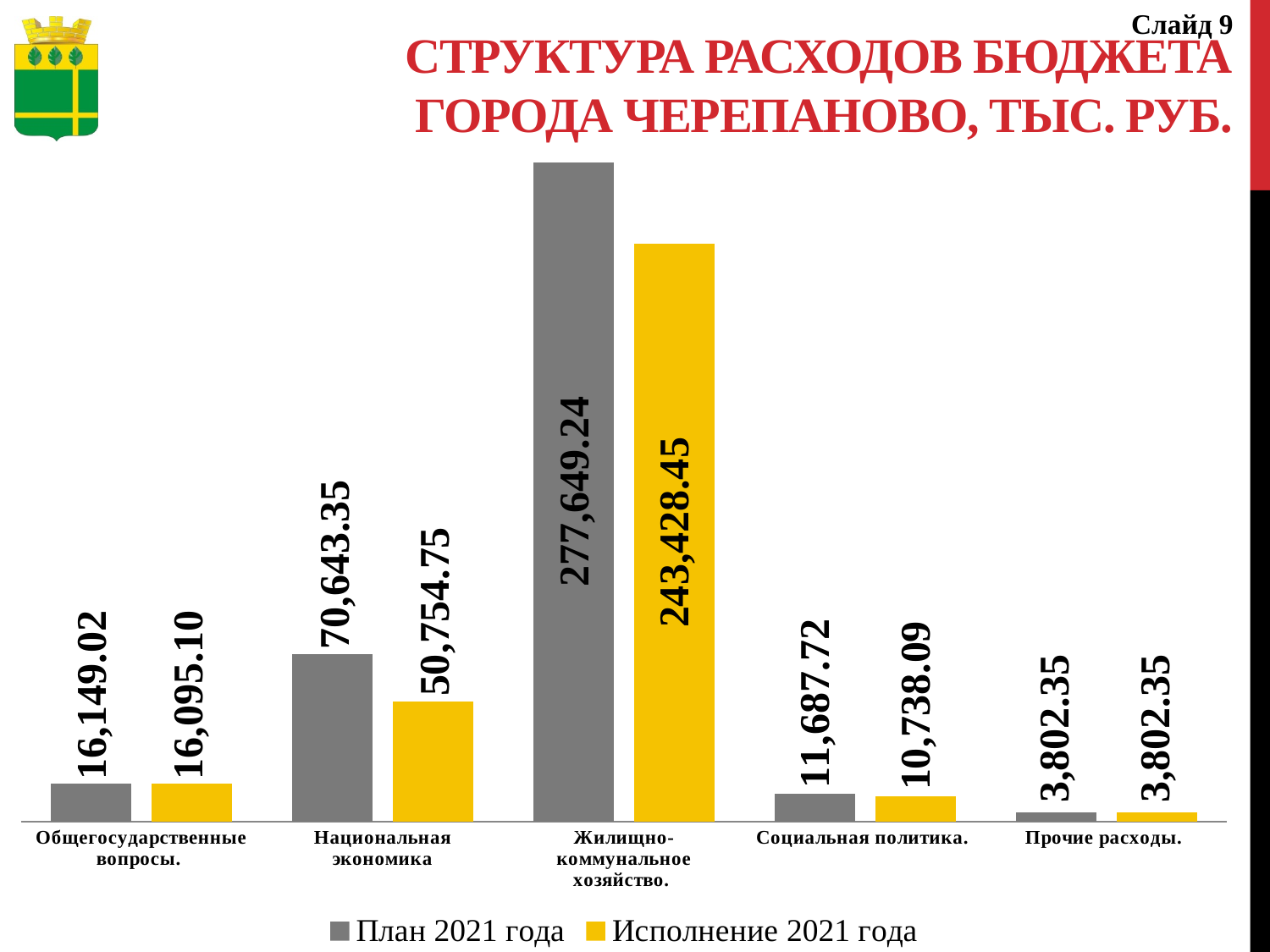
What is the value of Исполнение 2021 года for Социальная политика? 10,738.09 Which category has the highest value for План 2021 года? Жилищно-коммунальное хозяйство Which category has the lowest value for Исполнение 2021 года? Прочие расходы What is the value of Исполнение 2021 года for Национальная экономика? 50,754.75 What is the difference between План 2021 года and Исполнение 2021 года for Жилищно-коммунальное хозяйство? 34,220.79 How many categories are shown on the x axis? 5 What is the difference between План 2021 года and Исполнение 2021 года for Национальная экономика? 19,888.60 What is the value of План 2021 года for Общегосударственные вопросы? 16,149.02 Which is larger for Социальная политика: План 2021 года or Исполнение 2021 года? План 2021 года What is the value of План 2021 года for Жилищно-коммунальное хозяйство? 277,649.24 What type of chart is shown on the slide? Bar chart How many series does the legend list? 2